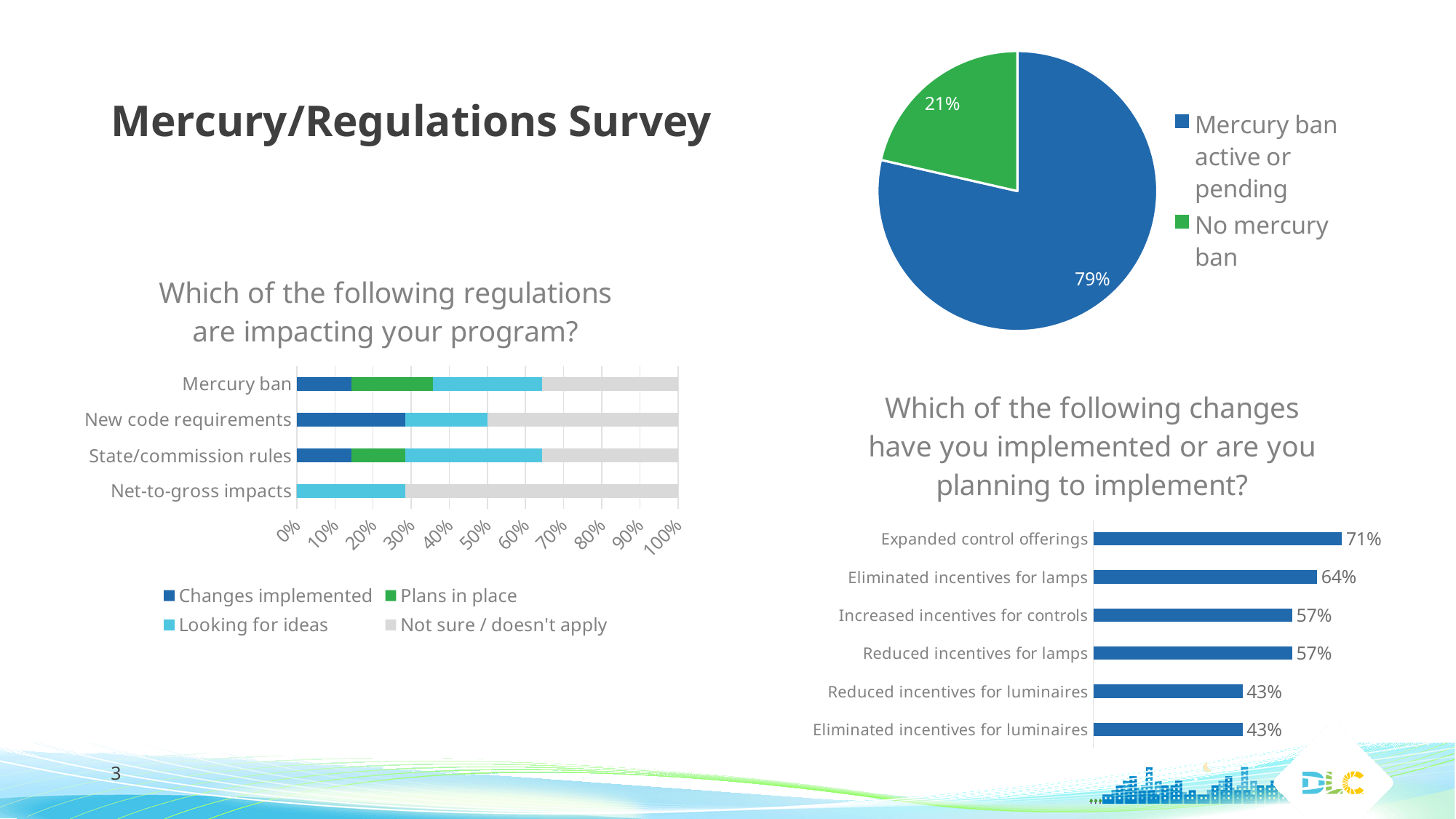
How many entries does the legend of the pie chart at the top right list? 2 In the chart titled 'Which of the following changes have you implemented or are you planning to implement?', what is the difference between 'Expanded control offerings' and 'Eliminated incentives for lamps'? 7 percentage points In the pie chart at the top right, what percentage is shown for 'No mercury ban'? 21% In the pie chart at the top right, what share of respondents have a mercury ban active or pending? 79% In the chart titled 'Which of the following changes have you implemented or are you planning to implement?', which is larger: 'Reduced incentives for lamps' or 'Reduced incentives for luminaires'? Reduced incentives for lamps In the chart titled 'Which of the following changes have you implemented or are you planning to implement?', what is the value for 'Eliminated incentives for lamps'? 64% In the chart titled 'Which of the following changes have you implemented or are you planning to implement?', how many categories are shown? 6 How many series does the legend of the chart 'Which of the following regulations are impacting your program?' list? 4 In the chart 'Which of the following regulations are impacting your program?', how many regulation categories are listed? 4 In the chart titled 'Which of the following changes have you implemented or are you planning to implement?', which category has the highest value? Expanded control offerings In the chart 'Which of the following regulations are impacting your program?', is the 'Changes implemented' value for 'Mercury ban' greater or less than 20%? less What kind of chart is 'Which of the following regulations are impacting your program?' Stacked bar chart